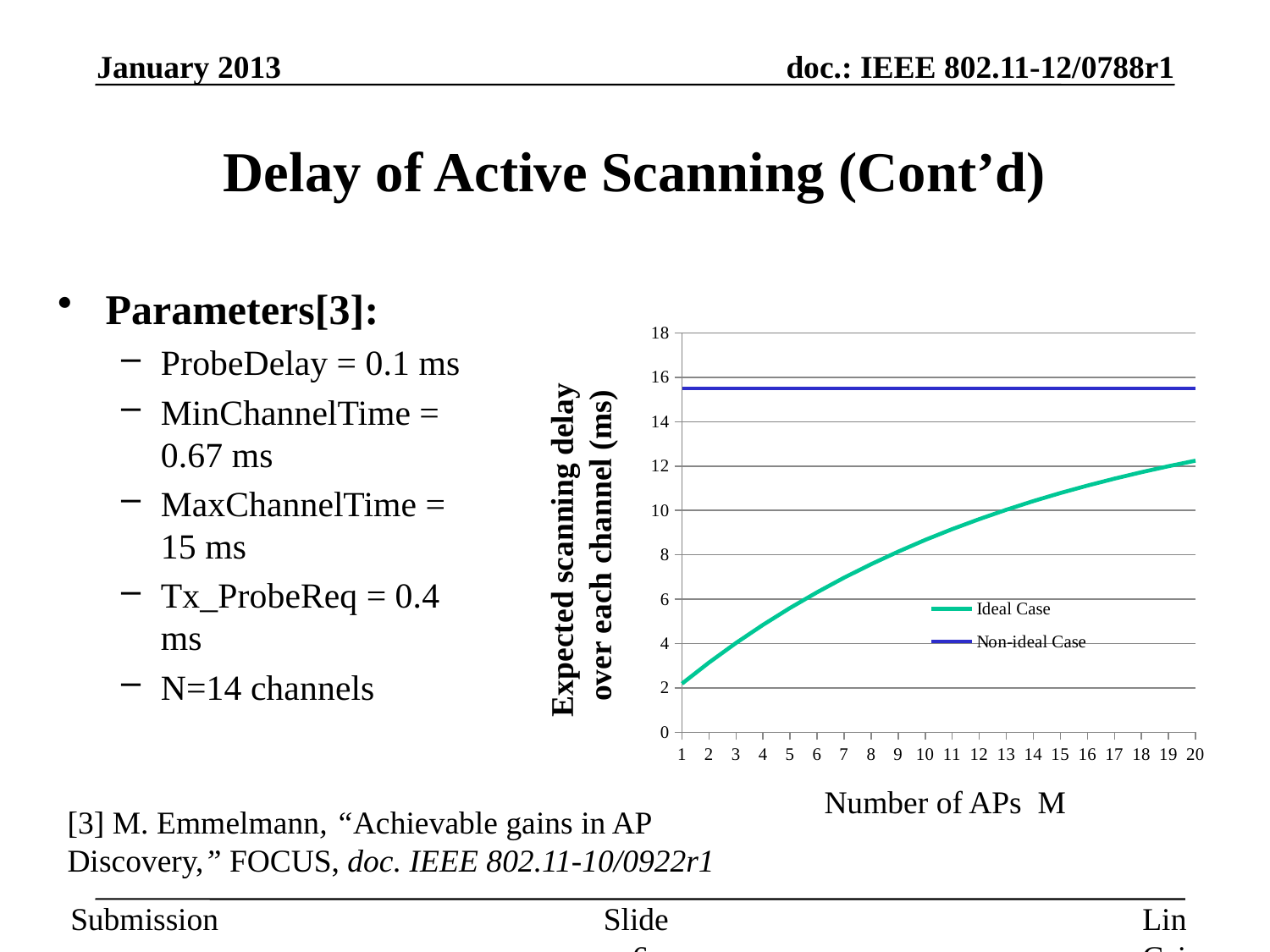
Is the Ideal Case value at M = 5 greater or less than 8? less Is the Non-ideal Case value greater or less than 14? greater What is the label of the y axis of the chart? Expected scanning delay over each channel (ms) What are the two series named in the chart legend? Ideal Case and Non-ideal Case How many values of M (Number of APs) are plotted along the x axis? 20 Does the Ideal Case line rise or fall as the Number of APs M increases? rises Which series has the higher expected scanning delay at M = 10, Ideal Case or Non-ideal Case? Non-ideal Case How many series does the chart legend list? 2 Is the Ideal Case value at M = 1 greater or less than 4? less What kind of chart is shown on the slide? line chart Does the Non-ideal Case line rise, fall, or stay flat as the Number of APs M increases? stays flat